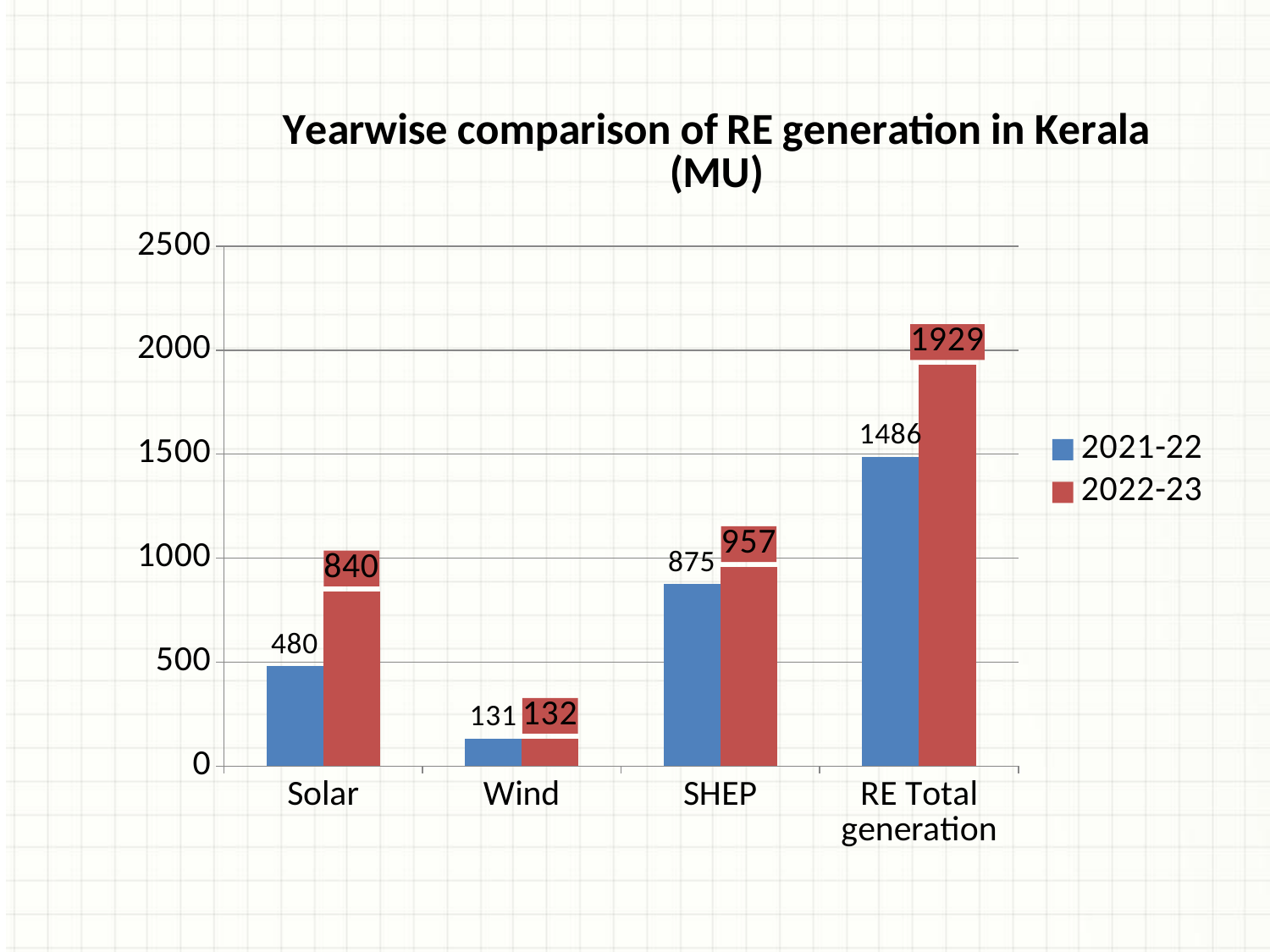
How many series does the legend list? 2 Which category has the highest value for 2021-22? RE Total generation How many categories are shown on the x axis? 4 What kind of chart is shown on the slide? Bar chart Which category has the lowest value for 2022-23? Wind What is the SHEP generation value for 2021-22? 875 What is the difference between the 2022-23 and 2021-22 values for RE Total generation? 443 What is the RE Total generation value for 2022-23? 1929 What is the Wind generation value for 2021-22? 131 What is the Solar generation value for 2022-23? 840 Which is larger for SHEP, the 2021-22 value or the 2022-23 value? 2022-23 What is the difference between the 2022-23 and 2021-22 values for Solar? 360